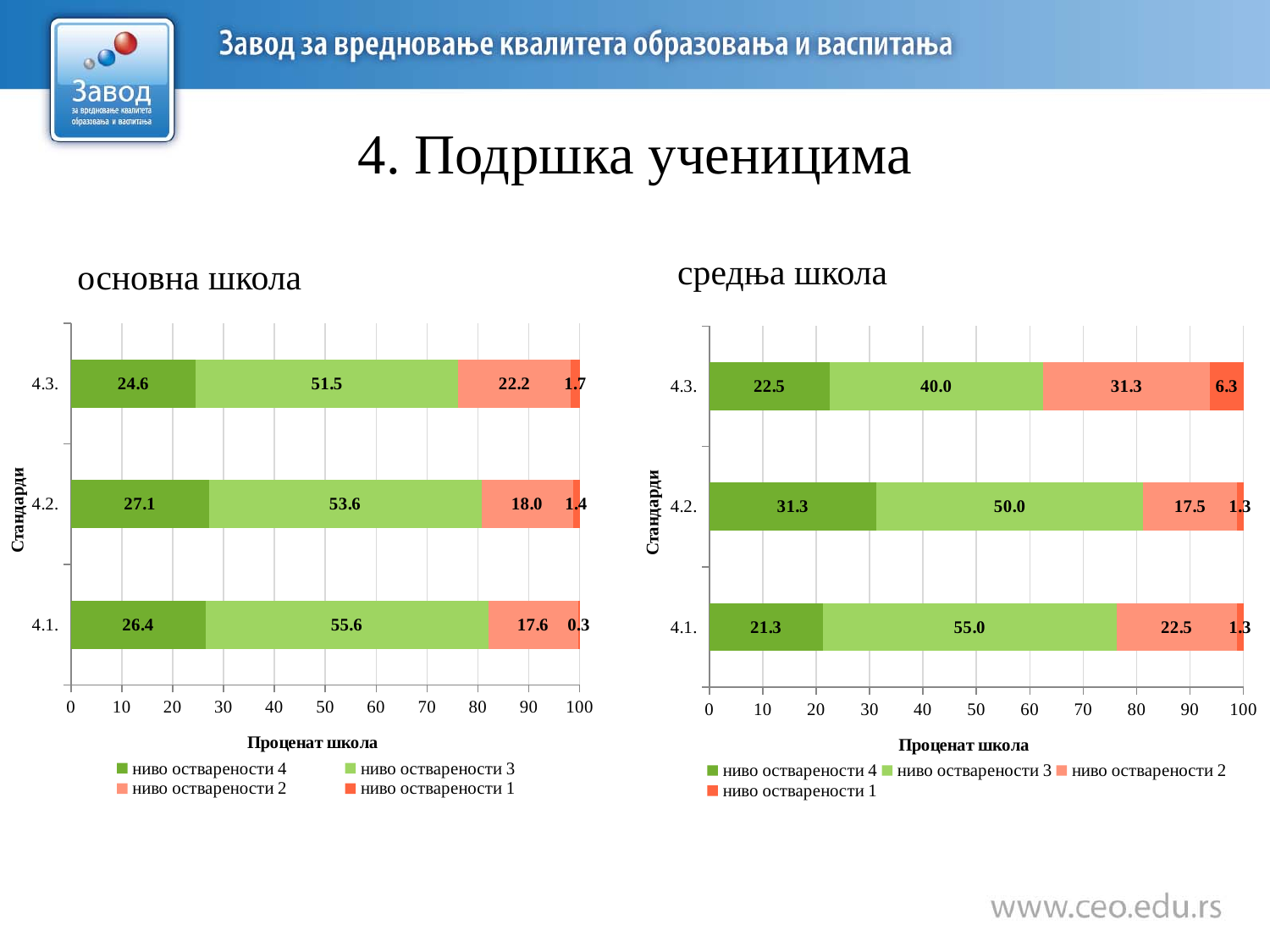
What type of chart is the 'основна школа' chart? Stacked bar chart In the 'средња школа' chart, what is the difference between 'ниво остварености 3' for standard 4.1. and for standard 4.3.? 15.0 In the 'средња школа' chart, what is the value of 'ниво остварености 2' for standard 4.3.? 31.3 How many series does the legend of the 'средња школа' chart list? 4 In the 'основна школа' chart, which standard has the lowest value for 'ниво остварености 2'? 4.1. In the 'основна школа' chart, which is larger: 'ниво остварености 4' for standard 4.2. or for standard 4.3.? 4.2. In the 'основна школа' chart, what is the value of 'ниво остварености 3' for standard 4.1.? 55.6 In the 'основна школа' chart, what is the value of 'ниво остварености 1' for standard 4.1.? 0.3 In the 'средња школа' chart, what is the total of the stacked bar for standard 4.2.? 100.1 What is the x-axis title of the 'средња школа' chart? Проценат школа In the 'средња школа' chart, which standard has the highest value for 'ниво остварености 4'? 4.2. How many standards (categories) are shown in the 'основна школа' chart? 3